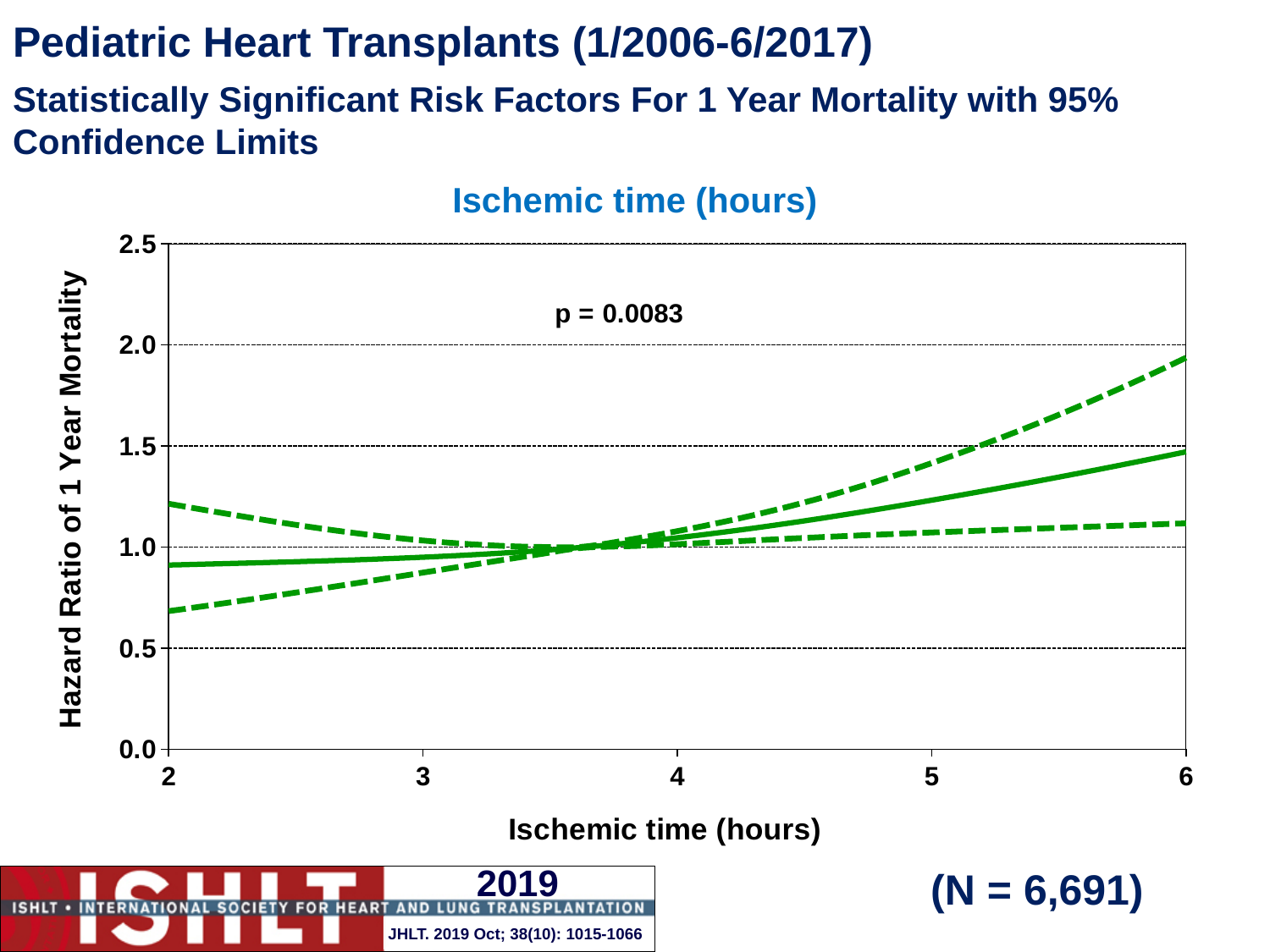
Does the solid hazard ratio line rise or fall as ischemic time increases from 2 to 6 hours? rise Is the hazard ratio (solid line) at 6 hours of ischemic time greater or less than 1.0? greater What p-value is printed on the chart? p = 0.0083 What is the label of the y axis? Hazard Ratio of 1 Year Mortality What is the title of the chart? Ischemic time (hours) What is the sample size (N) shown on the slide? 6,691 Is the hazard ratio (solid line) at 2 hours of ischemic time greater or less than 1.0? less Is the lower 95% confidence limit (lower dashed line) at 6 hours greater or less than 1.5? less How many lines are plotted on the chart? 3 What kind of chart is shown on the slide? line chart